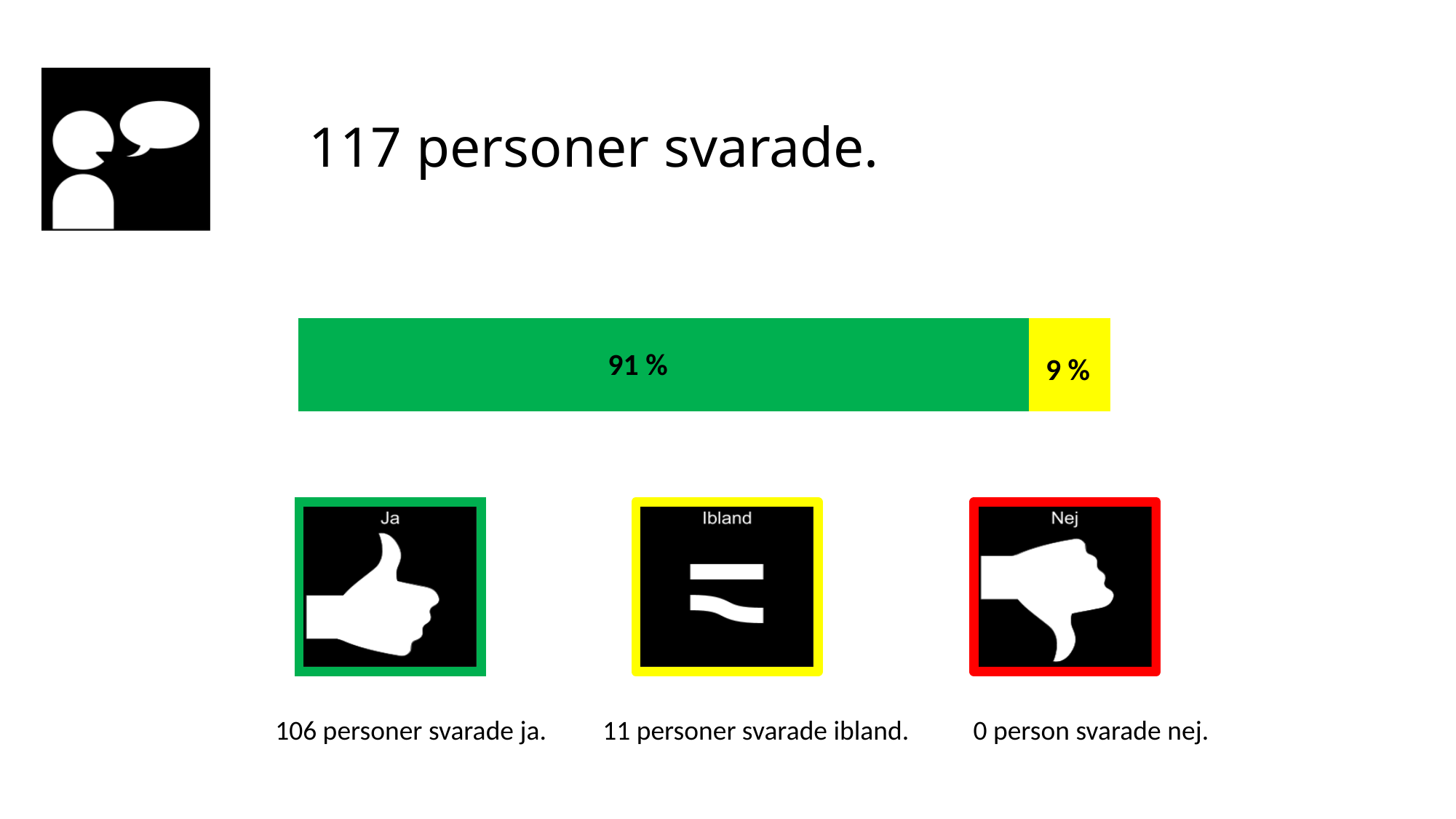
Is the value of the green segment greater or less than 50 %? greater What is the total of the two percentages shown on the bar? 100 % How many segments does the bar have? 2 What colour is the segment labelled 91 %? green Which segment of the bar is the smallest? the yellow segment (9 %) According to the slide, how many people answered in total? 117 What kind of chart is shown on the slide? bar chart What is the difference in percentage points between the green segment and the yellow segment of the bar? 82 What percentage is shown on the yellow segment of the bar? 9 % Which segment of the bar is larger, the green one or the yellow one? the green one What percentage is shown on the green segment of the bar? 91 %